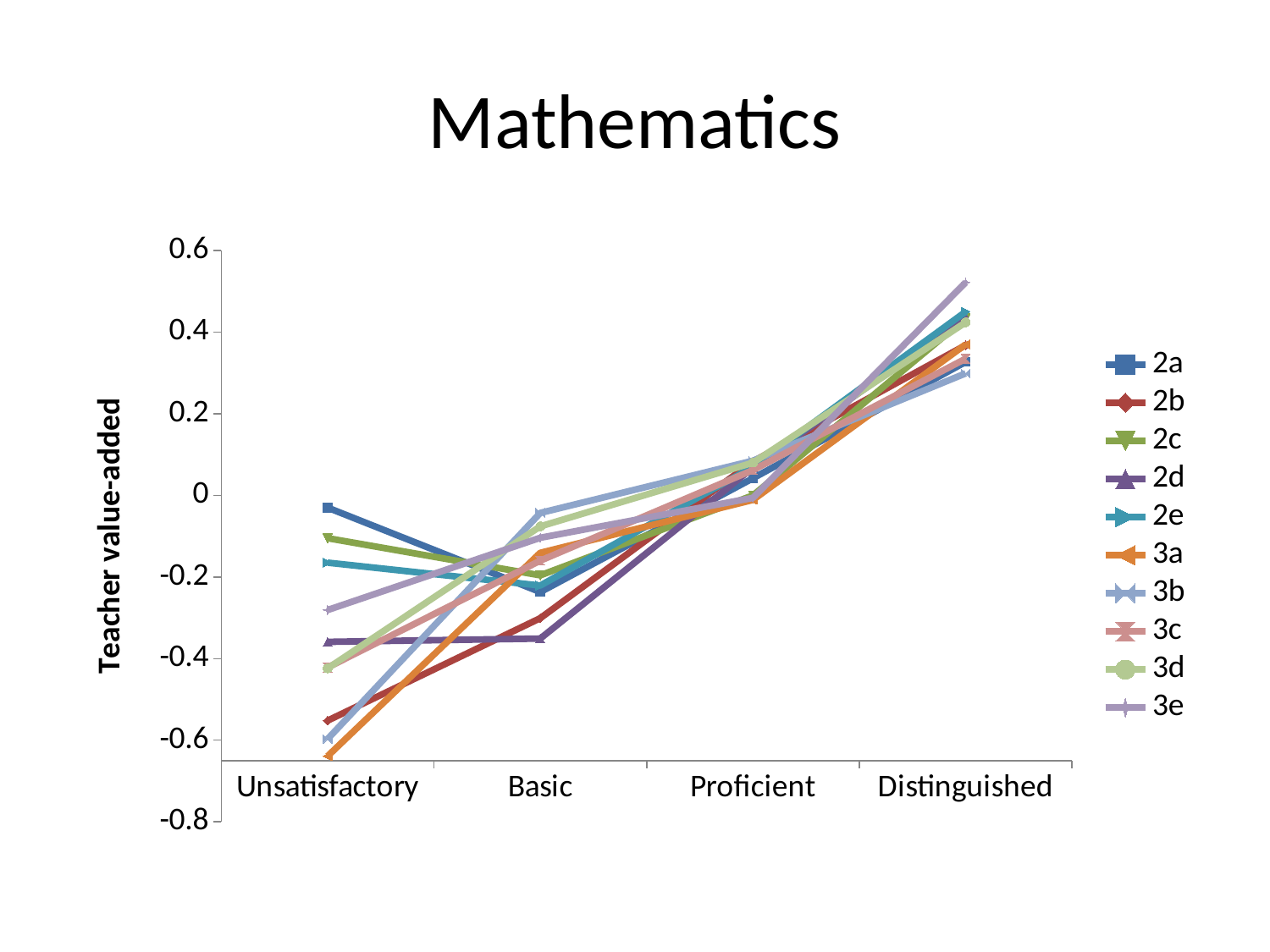
Does the value for 3e rise or fall from Unsatisfactory to Distinguished? rise Which series has the highest value at Unsatisfactory? 2a Which series has the lowest value at Unsatisfactory? 3a Is the value for 3e at Distinguished greater or less than 0.4? greater How many series does the legend list? 10 What is the title of the chart? Mathematics Is the value for 2d at Basic greater or less than -0.2? less What kind of chart is shown on the slide? line chart How many categories are shown on the x axis? 4 At Distinguished, which is larger: the value for 3e or the value for 3b? 3e What is the label on the vertical axis? Teacher value-added Which series has the highest value at Distinguished? 3e